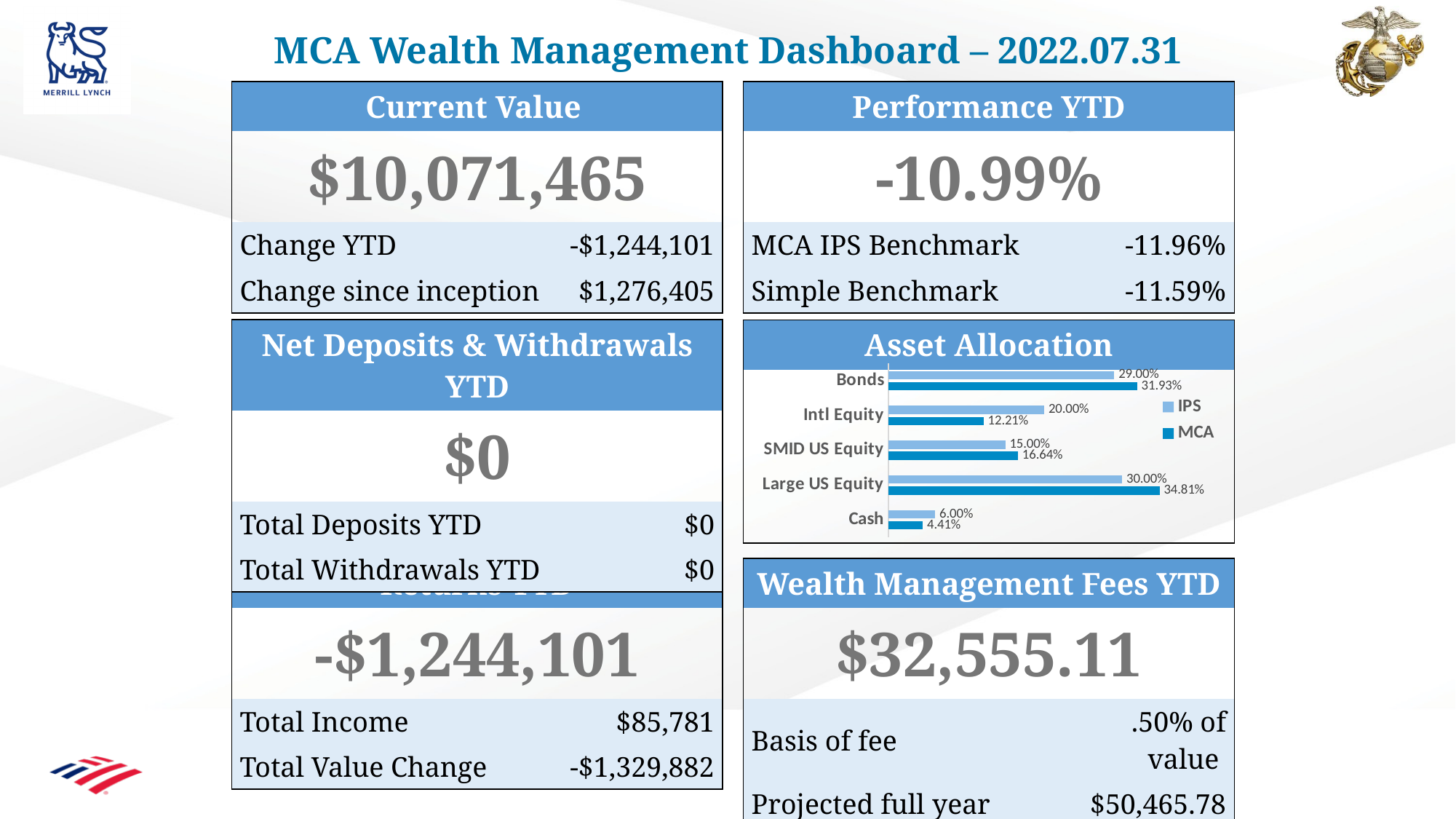
In the Asset Allocation chart, which category has the lowest IPS value? Cash In the Asset Allocation chart, which category has the highest MCA value? Large US Equity In the Asset Allocation chart, what is the MCA value for Bonds? 31.93% In the Asset Allocation chart, what is the MCA value for Cash? 4.41% What are the two series named in the legend of the Asset Allocation chart? IPS and MCA What type of chart is the Asset Allocation chart? Bar chart In the Asset Allocation chart, what is the IPS value for SMID US Equity? 15.00% In the Asset Allocation chart, what is the difference between the MCA and IPS values for Large US Equity? 4.81% How many categories are shown in the Asset Allocation chart? 5 In the Asset Allocation chart, what is the IPS value for Intl Equity? 20.00% How many series does the legend of the Asset Allocation chart list? 2 In the Asset Allocation chart, which is larger for Intl Equity, the IPS value or the MCA value? IPS